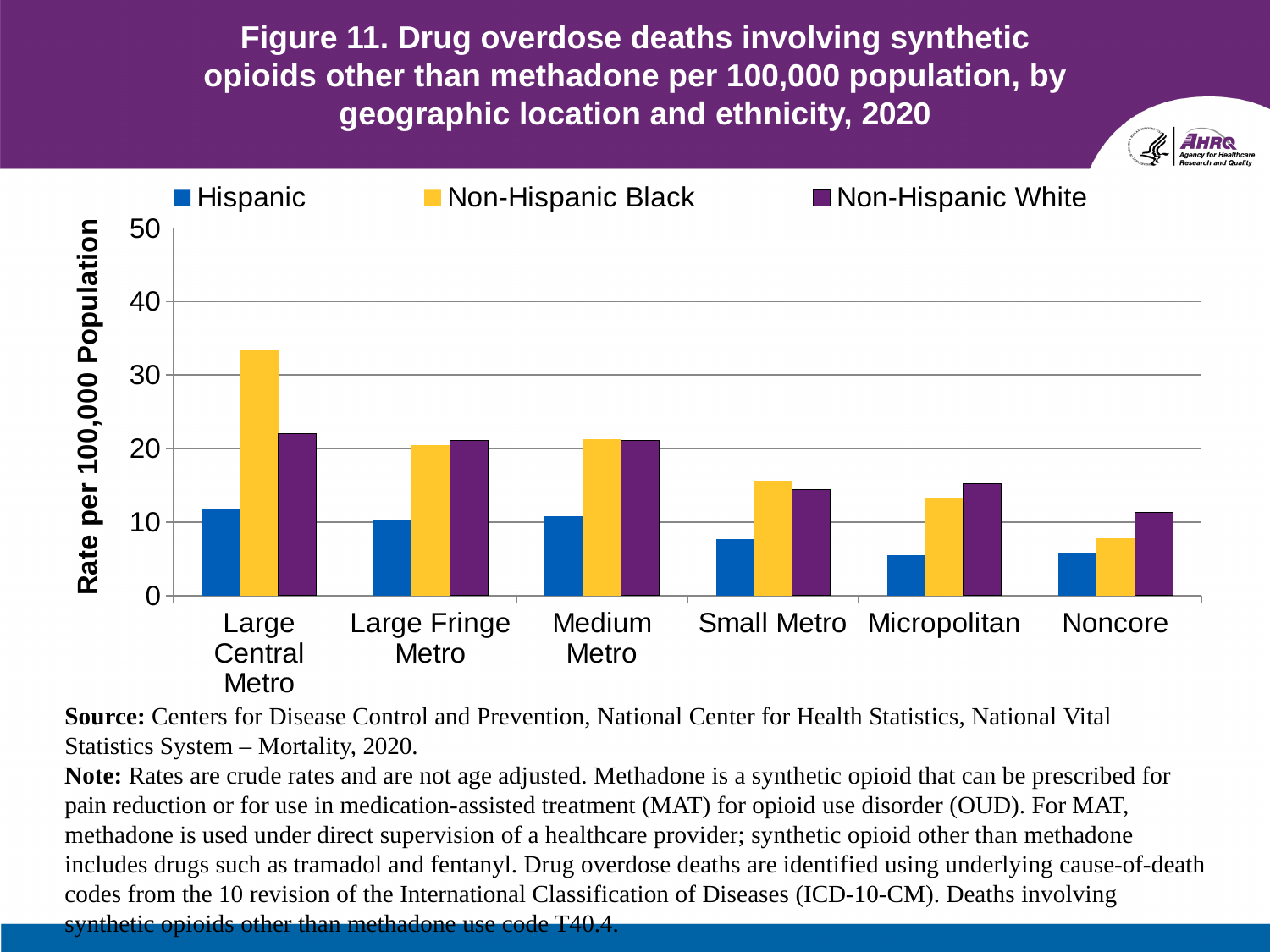
In Large Central Metro, which is larger: the Non-Hispanic Black rate or the Non-Hispanic White rate? Non-Hispanic Black In Micropolitan, which is larger: the Non-Hispanic Black rate or the Non-Hispanic White rate? Non-Hispanic White What colour represents the Hispanic series in the legend? blue Which geographic location has the highest rate for Non-Hispanic Black? Large Central Metro Which geographic location has the lowest rate for Non-Hispanic White? Noncore What kind of chart is shown on the slide? bar chart Is the Non-Hispanic White rate for Noncore greater or less than 10? greater Which geographic location has the lowest rate for Non-Hispanic Black? Noncore Is the Hispanic rate for Micropolitan greater or less than 10? less How many geographic location categories are shown on the x axis? 6 How many series does the legend list? 3 Is the Non-Hispanic Black rate for Large Central Metro greater or less than 30? greater